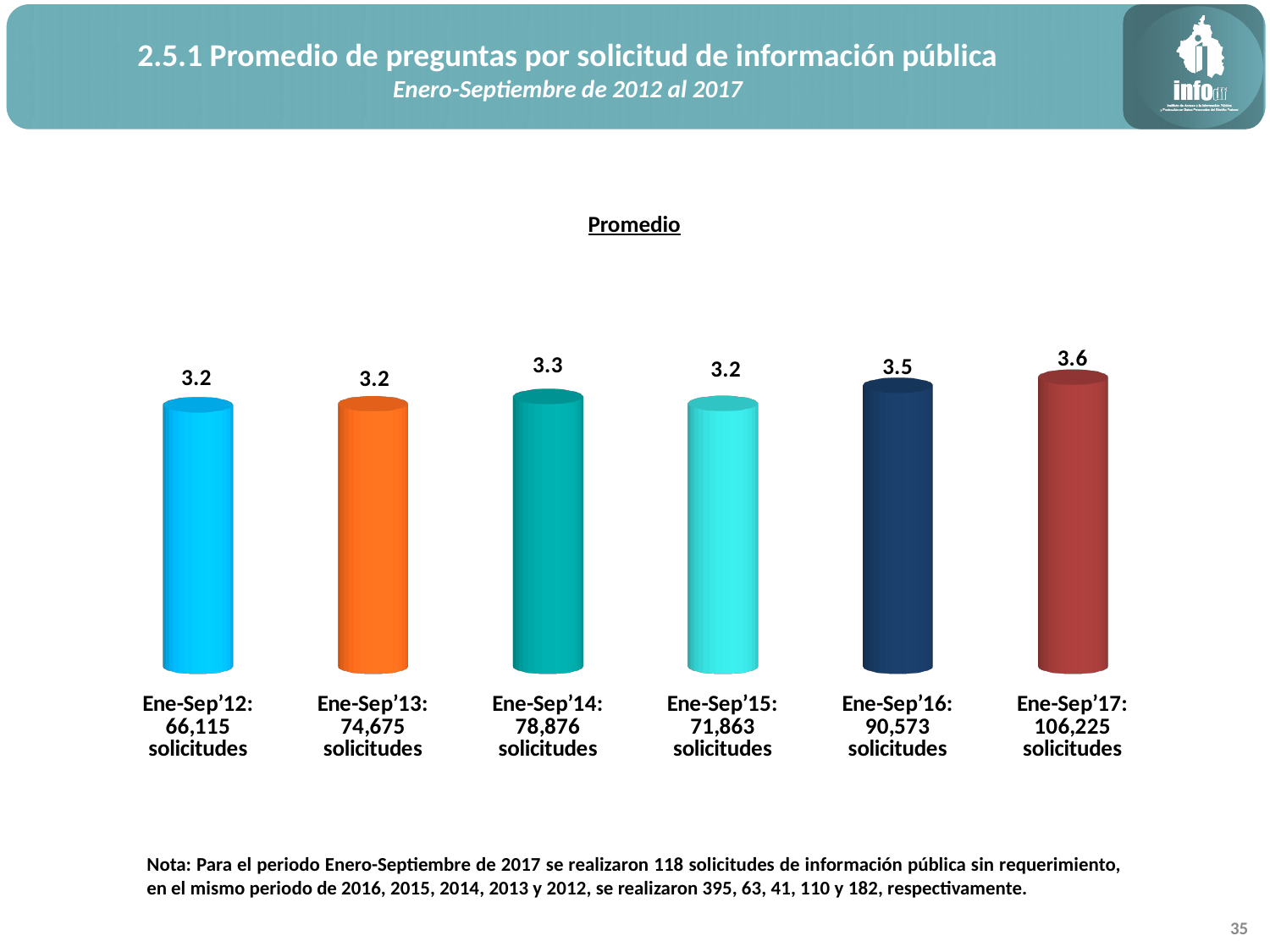
What is the average number of questions per request for Ene-Sep'17? 3.6 How many solicitudes are listed for Ene-Sep'12? 66,115 What is the difference between the values for Ene-Sep'17 and Ene-Sep'12? 0.4 Which period has the highest average? Ene-Sep'17 Which is larger, the value for Ene-Sep'14 or the value for Ene-Sep'15? Ene-Sep'14 What is the value shown for Ene-Sep'16? 3.5 What is the label shown above the chart? Promedio What kind of chart is shown on the slide? Bar chart What is the difference between the values for Ene-Sep'16 and Ene-Sep'15? 0.3 What is the value shown for Ene-Sep'14? 3.3 How many solicitudes are listed for Ene-Sep'17? 106,225 How many periods (bars) are shown in the chart? 6